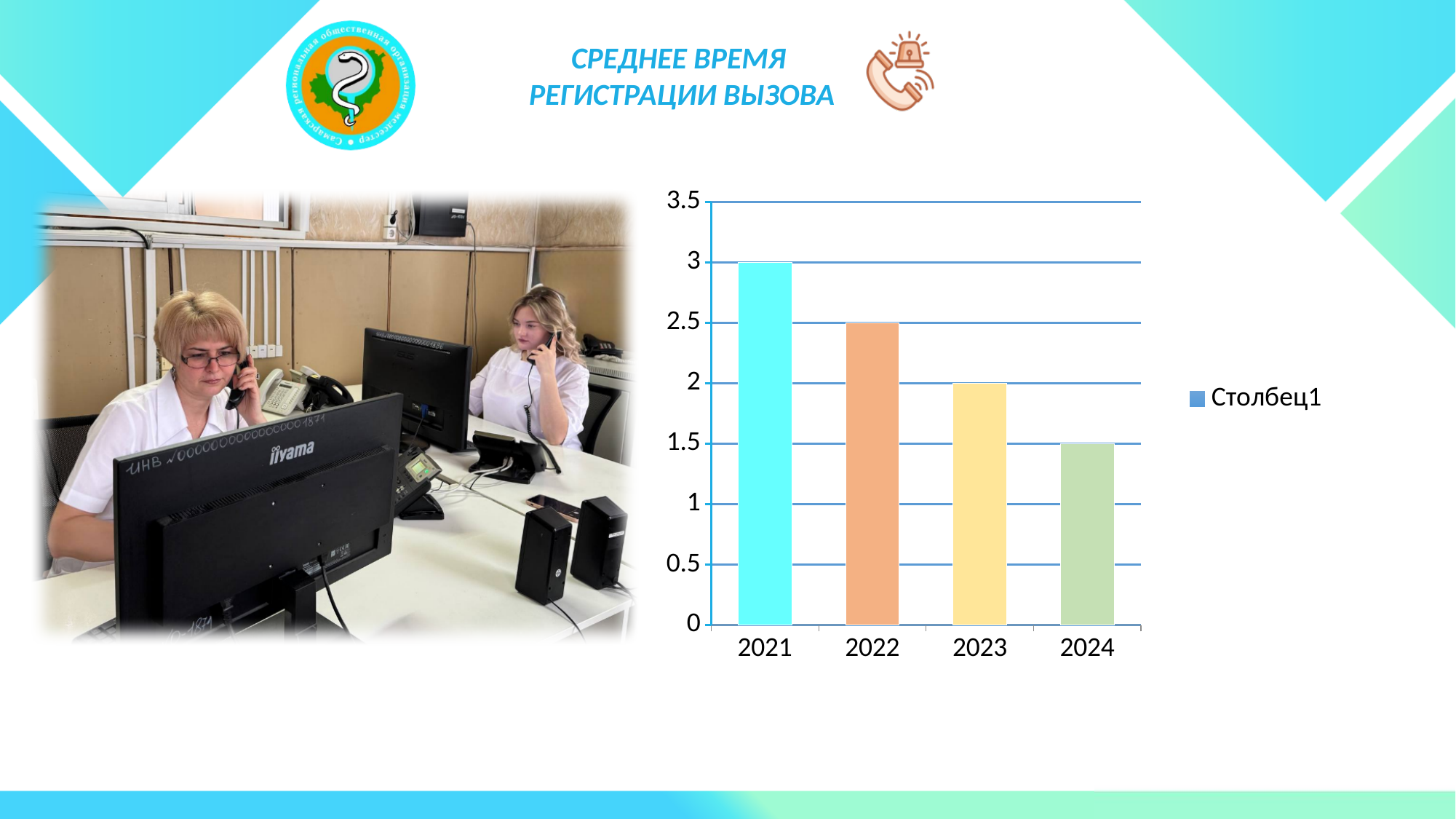
What kind of chart is shown on the slide? bar chart What is the value for 2023? 2 What entry does the legend list? Столбец1 What is the value for 2024? 1.5 What is the value for 2022? 2.5 Which is larger, the value for 2022 or the value for 2023? 2022 What is the difference between the values for 2021 and 2024? 1.5 Do the values rise or fall from 2021 to 2024? fall What is the value for 2021? 3 How many years are shown on the x axis? 4 Which year has the lowest value? 2024 Which year has the highest value? 2021